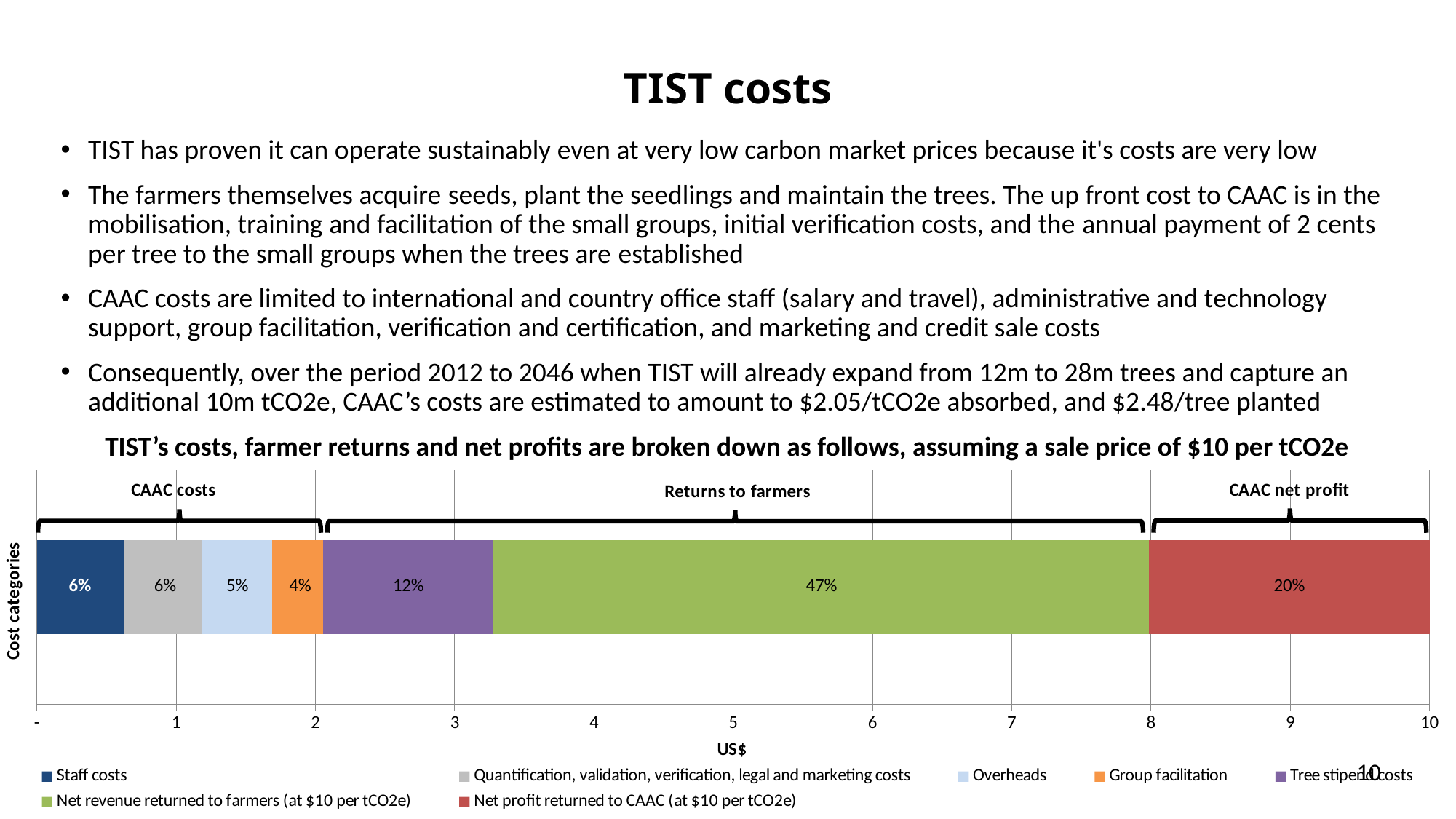
What percentage is shown for Group facilitation? 4% What kind of chart is shown on the slide? Stacked bar chart Which series has the largest share of the bar? Net revenue returned to farmers (at $10 per tCO2e) How many series does the legend list? 7 What percentage is shown for Tree stipend costs? 12% What percentage is shown for Overheads? 5% What is the difference in percentage points between the Net revenue returned to farmers segment and the Net profit returned to CAAC segment? 27 percentage points What percentage does the Net revenue returned to farmers segment show? 47% What percentage is labelled on the Net profit returned to CAAC segment? 20% What is the label on the x axis of the chart? US$ Which is larger, the Tree stipend costs segment or the Overheads segment? Tree stipend costs Which series has the smallest share of the bar? Group facilitation